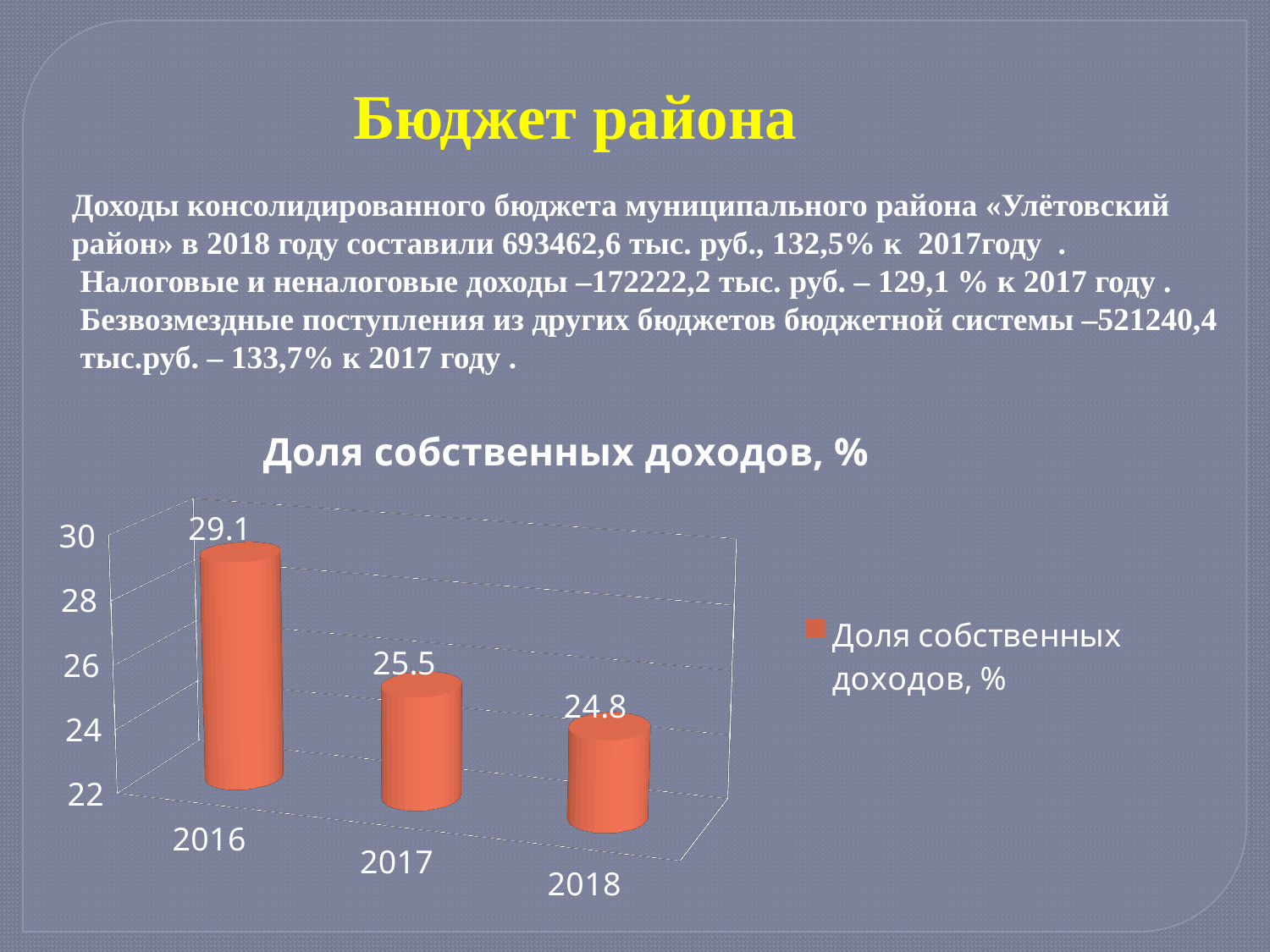
Do the values in the chart rise or fall from 2016 to 2018? fall What is the difference between the values for 2016 and 2018 in the chart? 4.3 Which year has the highest share of own revenues in the chart? 2016 What is the value for 2016 in the chart 'Доля собственных доходов, %'? 29.1 Which is larger in the chart, the value for 2016 or the value for 2017? 2016 What is the value for 2017 in the chart 'Доля собственных доходов, %'? 25.5 What is the value for 2018 in the chart 'Доля собственных доходов, %'? 24.8 What is the difference between the values for 2017 and 2018 in the chart? 0.7 Which year has the lowest share of own revenues in the chart? 2018 How many series does the chart legend list? 1 What kind of chart is shown on the slide? bar chart How many years are shown on the x axis of the chart? 3